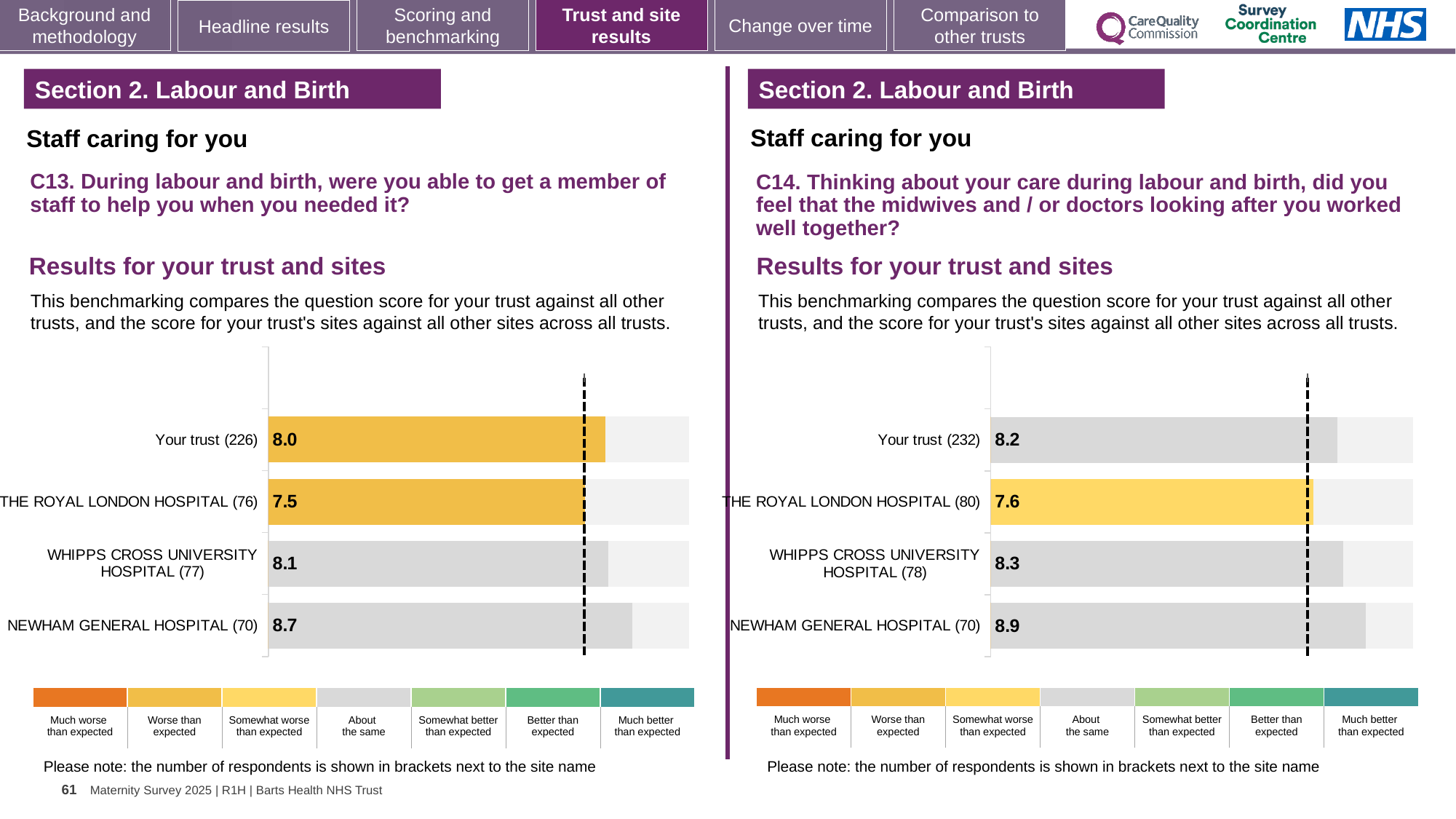
What type of chart is used in the C14 chart on the right? Bar chart In the C13 chart on the left, what is the score for THE ROYAL LONDON HOSPITAL (76)? 7.5 How many bars are shown in the C13 chart on the left? 4 In the C13 chart on the left, which site or trust has the highest score? NEWHAM GENERAL HOSPITAL (70) In the C14 chart on the right, what is the score for NEWHAM GENERAL HOSPITAL (70)? 8.9 In the C14 chart on the right, which benchmarking category does the colour of the bar for THE ROYAL LONDON HOSPITAL (80) correspond to? Somewhat worse than expected In the C13 chart on the left, what is the difference between the scores for NEWHAM GENERAL HOSPITAL (70) and THE ROYAL LONDON HOSPITAL (76)? 1.2 In the C14 chart on the right, which has the higher score: Your trust (232) or WHIPPS CROSS UNIVERSITY HOSPITAL (78)? WHIPPS CROSS UNIVERSITY HOSPITAL (78) In the C14 chart on the right, which site or trust has the lowest score? THE ROYAL LONDON HOSPITAL (80) In the C14 chart on the right, what is the difference between the scores for Your trust (232) and THE ROYAL LONDON HOSPITAL (80)? 0.6 In the C13 chart on the left, what is the score for Your trust (226)? 8.0 In the C14 chart on the right, what is the score for WHIPPS CROSS UNIVERSITY HOSPITAL (78)? 8.3